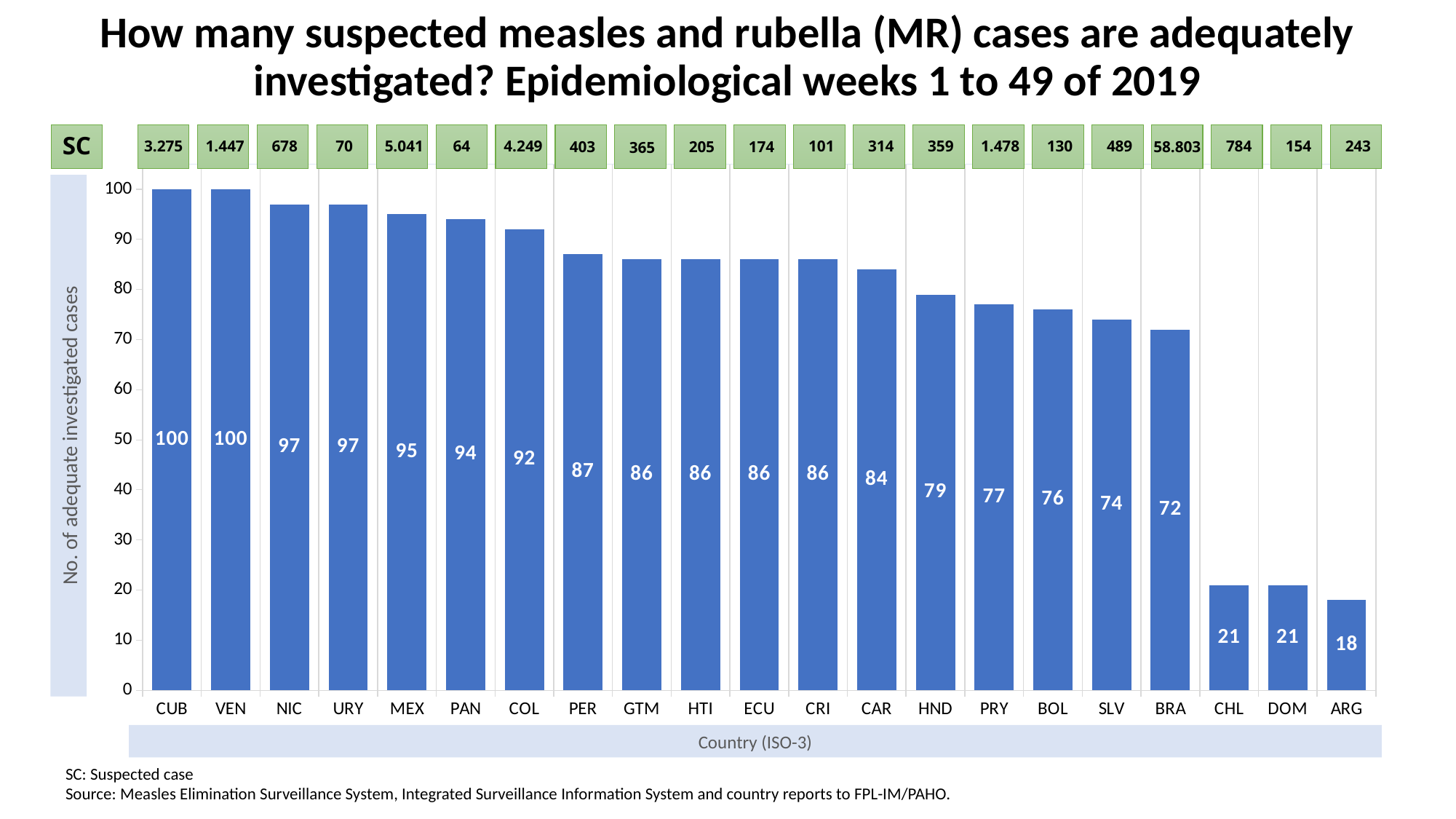
Which country has the lowest value? ARG What is the number of suspected cases (SC) shown for BRA? 58.803 What is the value for HND? 79 How many countries are shown on the x axis? 21 What is the difference between the values for CUB and ARG? 82 Which is larger, the value for PRY or the value for SLV? PRY Is the value for CHL greater or less than 30? less What is the value for BRA? 72 What is the value for MEX? 95 What is the difference between the values for COL and PER? 5 What kind of chart is this? bar chart Do the values rise or fall from left to right along the x axis? fall